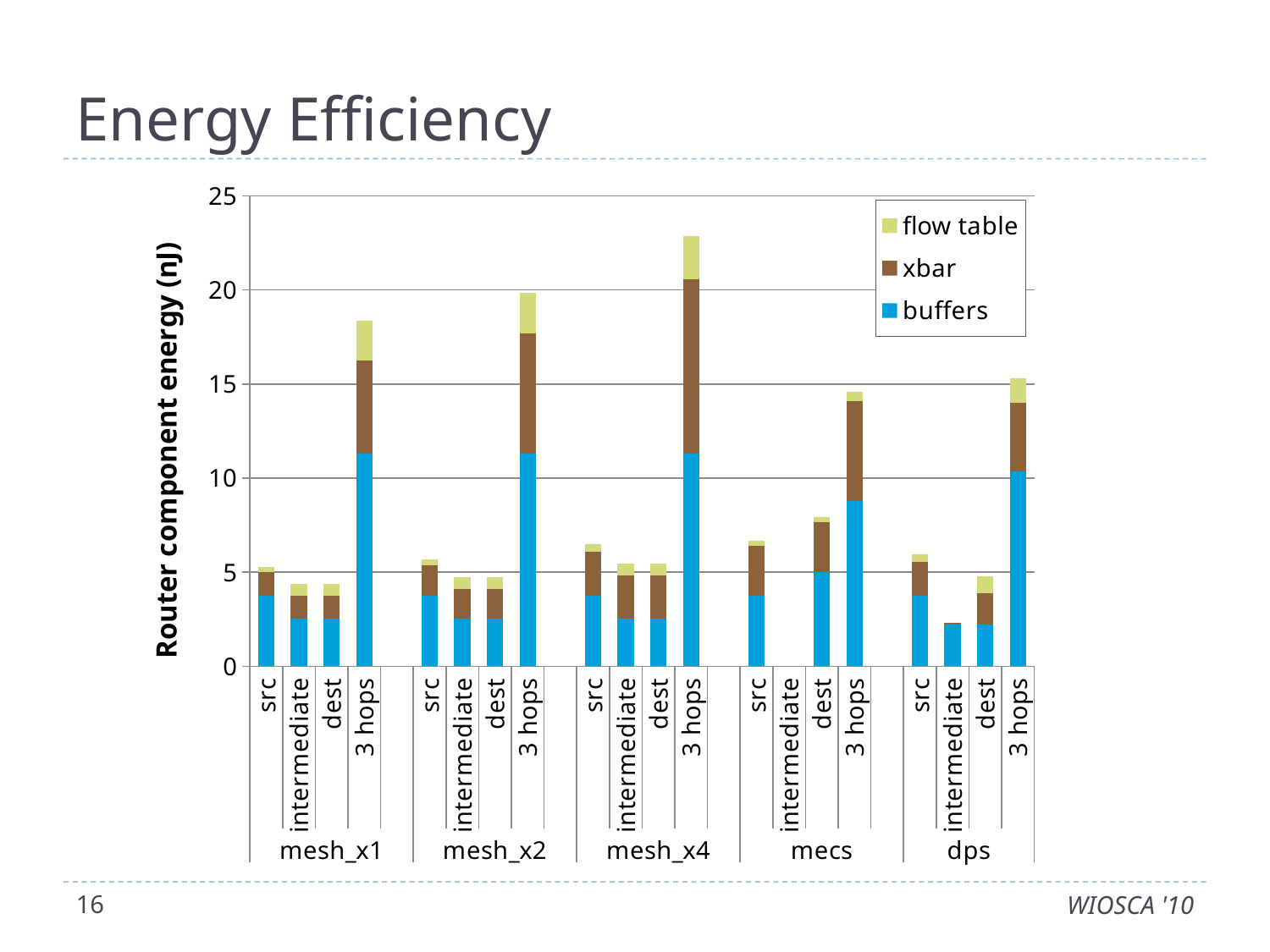
Which bar has the highest total router component energy? mesh_x4 3 hops What is the title of the vertical axis? Router component energy (nJ) How many network groups are labelled along the x axis? 5 Which is larger, the total for mesh_x4 3 hops or the total for mesh_x1 3 hops? mesh_x4 3 hops Is the total value for the dps intermediate bar greater or less than 5? less Is the total value for the mesh_x4 src bar greater or less than 5? greater How many series does the legend list? 3 What are the three series named in the legend? flow table, xbar, buffers Is the total value for the mesh_x4 3 hops bar greater or less than 20? greater What kind of chart is shown on the slide? stacked bar chart Which is larger, the total for mecs dest or the total for mesh_x1 dest? mecs dest